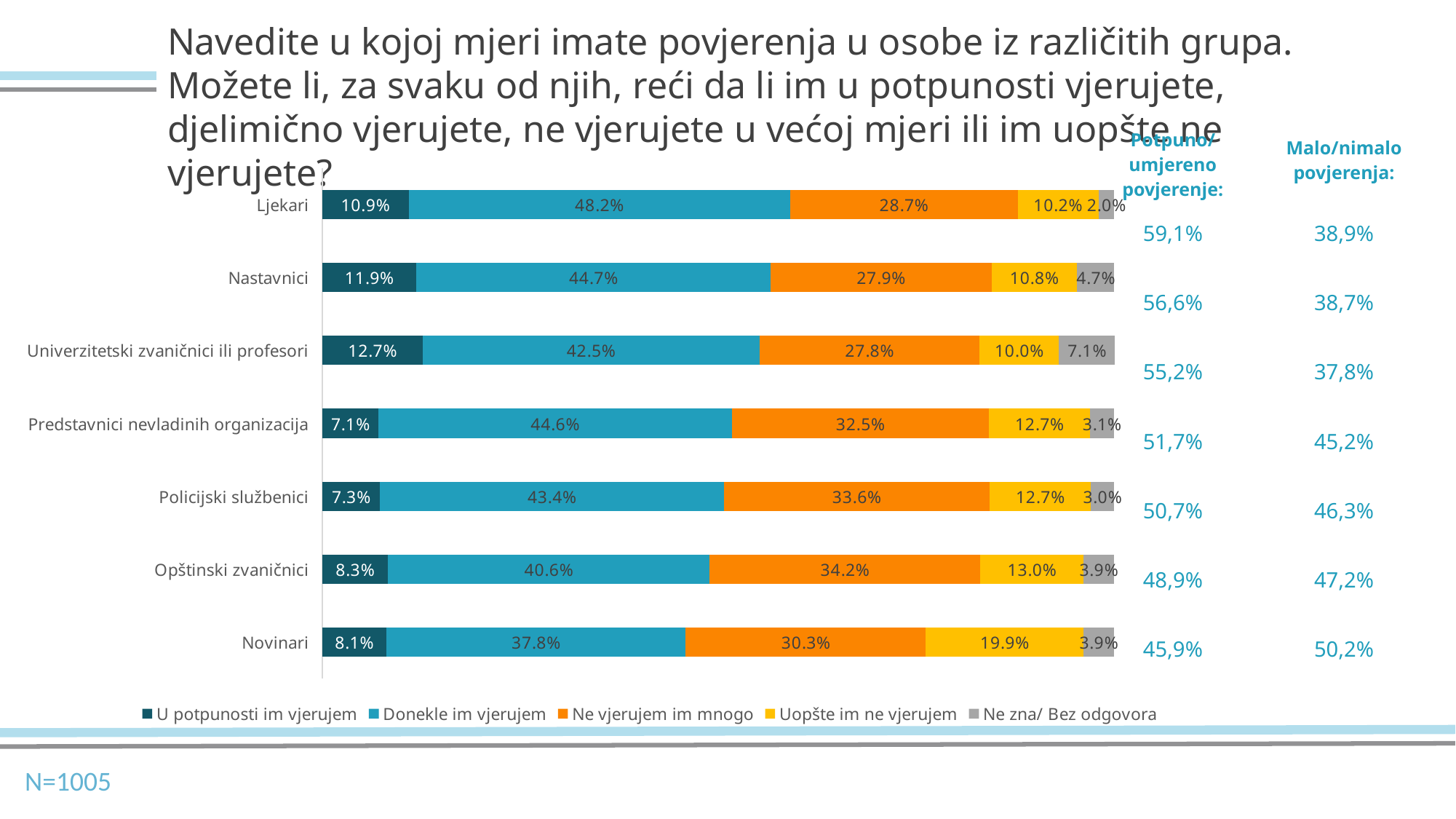
What is the "Ne zna/ Bez odgovora" value for Ljekari? 2.0% What colour represents "Ne vjerujem im mnogo" in the legend? Orange How many series does the legend list? 5 Which group has the lowest "Donekle im vjerujem" value? Novinari What percentage of respondents answered "Donekle im vjerujem" for Ljekari? 48.2% What type of chart is shown on the slide? Stacked bar chart Which has a larger "Ne zna/ Bez odgovora" value: Univerzitetski zvaničnici ili profesori or Nastavnici? Univerzitetski zvaničnici ili profesori Which group has the highest "Uopšte im ne vjerujem" value? Novinari What is the "Uopšte im ne vjerujem" value for Novinari? 19.9% Which group has the highest "U potpunosti im vjerujem" value? Univerzitetski zvaničnici ili profesori What is the difference between the "Ne vjerujem im mnogo" values for Opštinski zvaničnici and Ljekari? 5.5 percentage points How many groups (categories) are shown in the chart? 7